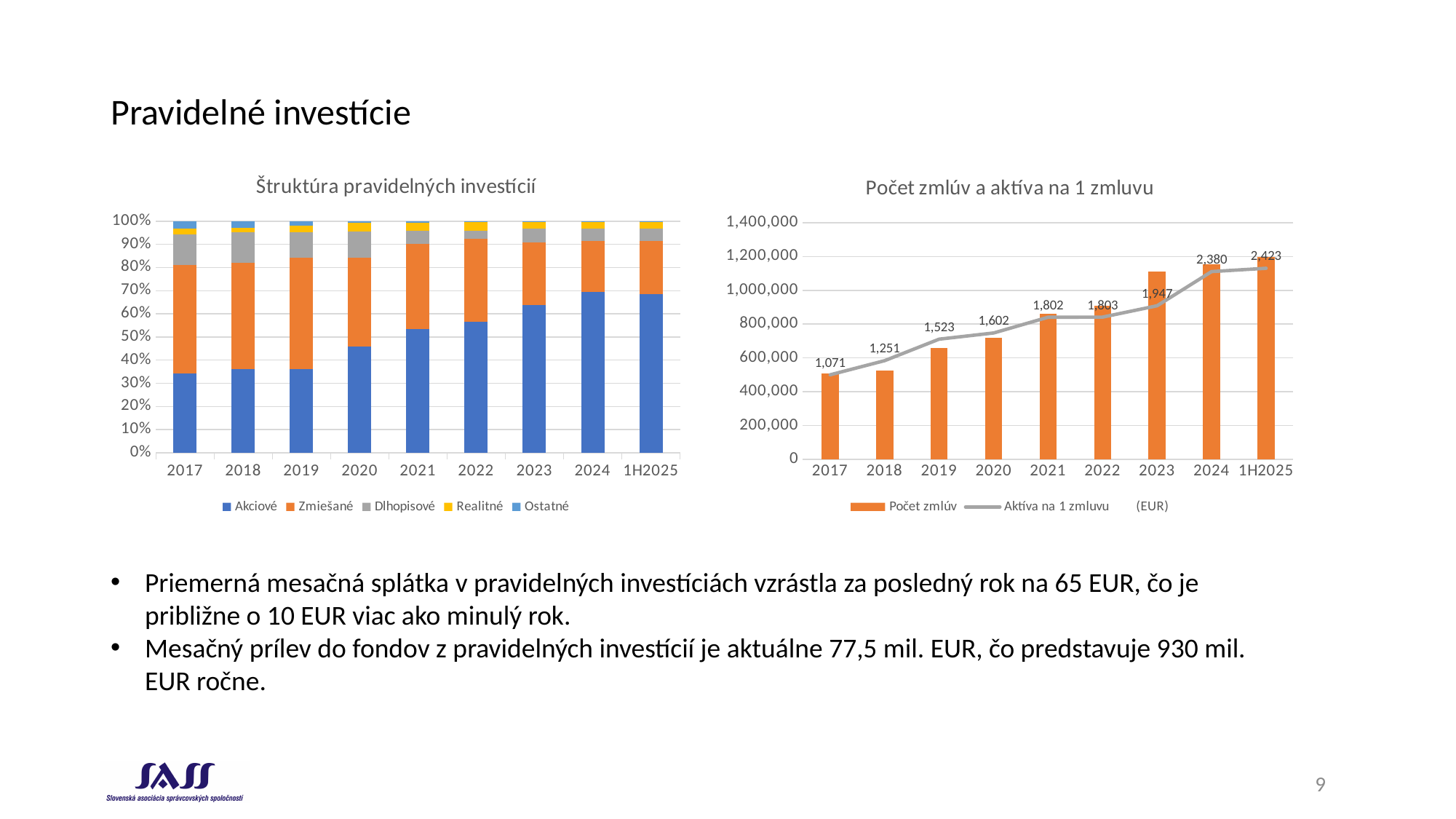
In the chart 'Počet zmlúv a aktíva na 1 zmluvu', by how much did Aktíva na 1 zmluvu increase from 2023 to 2024? 433 In the chart 'Počet zmlúv a aktíva na 1 zmluvu', what is the value of Aktíva na 1 zmluvu for 2024? 2,380 How many series does the legend of the chart 'Štruktúra pravidelných investícií' list? 5 In the chart 'Počet zmlúv a aktíva na 1 zmluvu', what is the value of Aktíva na 1 zmluvu for 2019? 1,523 In the chart 'Počet zmlúv a aktíva na 1 zmluvu', which year has the lowest Aktíva na 1 zmluvu? 2017 In the chart 'Počet zmlúv a aktíva na 1 zmluvu', what is the difference in Aktíva na 1 zmluvu between 1H2025 and 2017? 1,352 In the chart 'Počet zmlúv a aktíva na 1 zmluvu', is the Počet zmlúv bar for 2023 greater or less than 1,000,000? greater In the chart 'Počet zmlúv a aktíva na 1 zmluvu', does Aktíva na 1 zmluvu rise or fall from 2017 to 1H2025? rise In the chart 'Štruktúra pravidelných investícií', is the Akciové share for 2024 greater or less than 60%? greater In the chart 'Štruktúra pravidelných investícií', which year has the larger Akciové share, 2017 or 2023? 2023 In the chart 'Počet zmlúv a aktíva na 1 zmluvu', which period has the highest Aktíva na 1 zmluvu? 1H2025 In the chart 'Počet zmlúv a aktíva na 1 zmluvu', is the Počet zmlúv bar for 2017 greater or less than 600,000? less